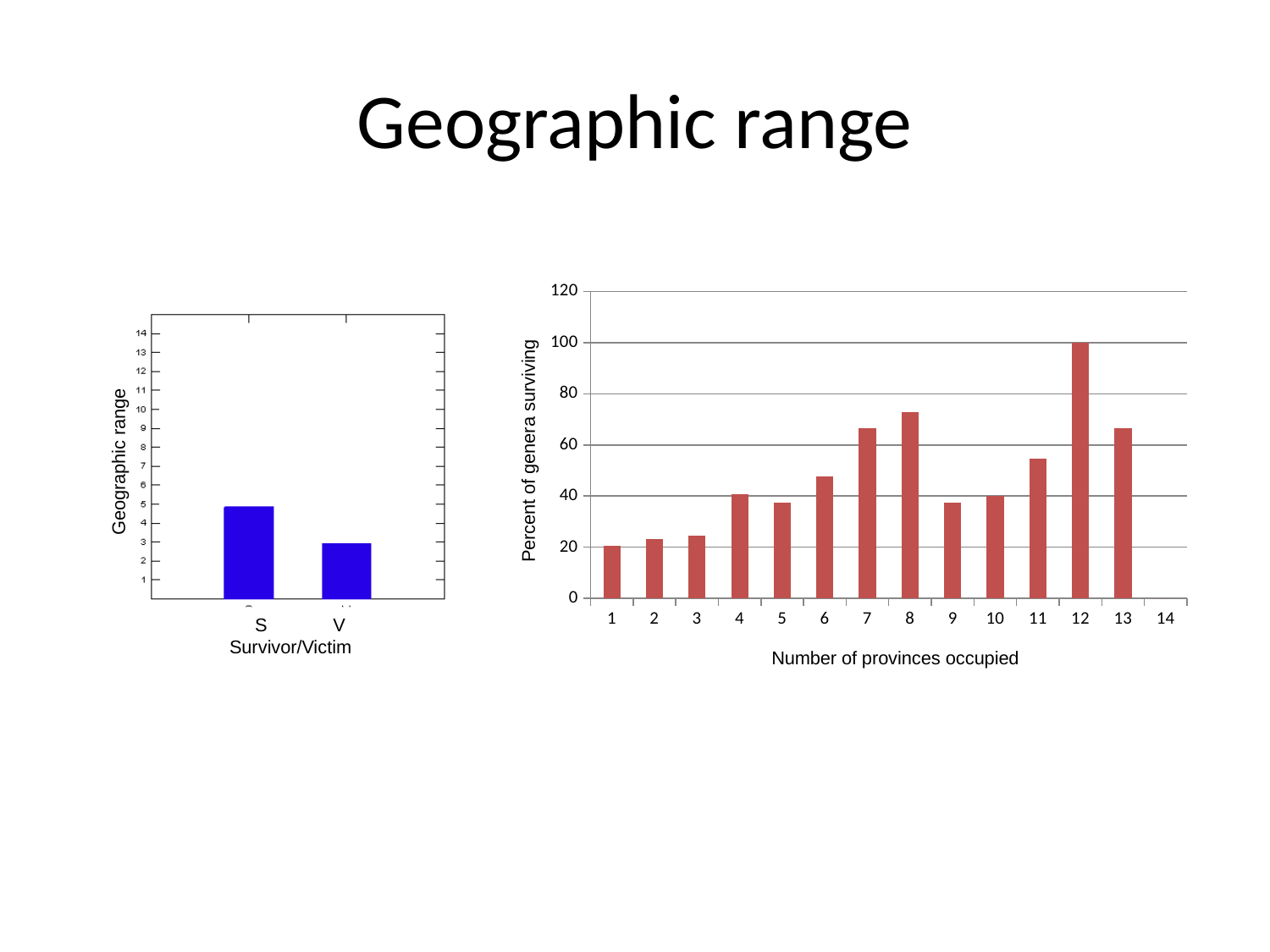
On the right chart (Percent of genera surviving), is the value for 8 provinces occupied greater or less than 60? greater On the right chart (Percent of genera surviving), what kind of chart is it? bar chart On the right chart (Percent of genera surviving), do the values generally rise or fall from 1 to 8 provinces occupied? rise On the right chart (Percent of genera surviving), is the value for 11 provinces occupied greater or less than 40? greater On the right chart (Percent of genera surviving), is the value for 1 province occupied greater or less than 40? less On the right chart (Percent of genera surviving), which number of provinces occupied has the highest percent of genera surviving? 12 On the right chart (Percent of genera surviving), how many categories are shown on the x axis? 14 On the right chart (Percent of genera surviving), which is larger, the value for 6 provinces or the value for 5 provinces? 6 provinces On the right chart, what is the label of the x axis? Number of provinces occupied On the left chart (Geographic range), which category has the higher geographic range, S or V? S On the right chart (Percent of genera surviving), what is the value for 12 provinces occupied? 100